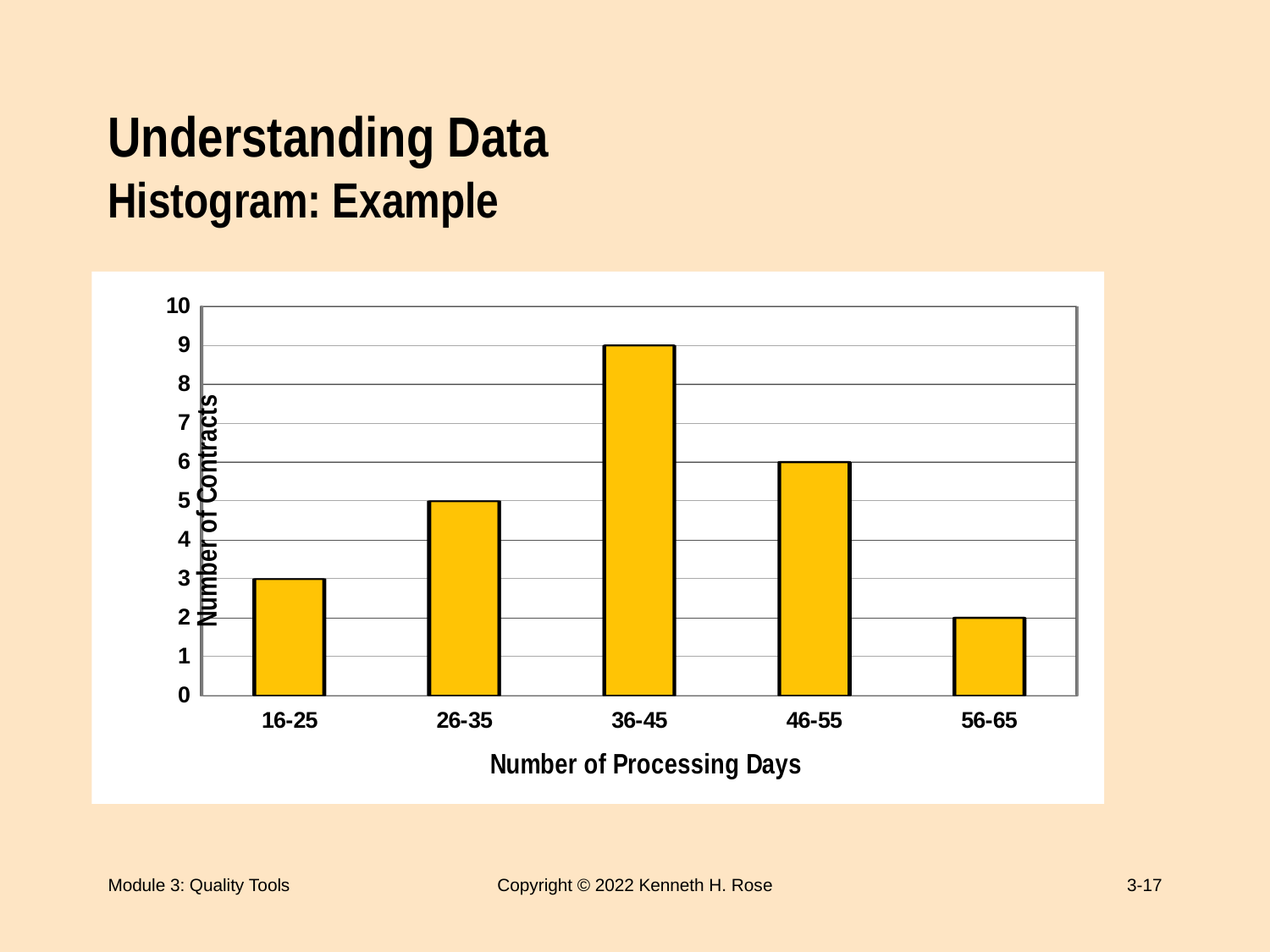
What is the difference in number of contracts between the 36-45 and 46-55 categories? 3 What is the number of contracts for the 16-25 processing days category? 3 What is the number of contracts for the 56-65 processing days category? 2 Which processing days category has the lowest number of contracts? 56-65 What is the label of the y axis? Number of Contracts Which has more contracts, the 26-35 category or the 46-55 category? 46-55 Which processing days category has the highest number of contracts? 36-45 How many contracts are shown for the 36-45 processing days category? 9 What kind of chart is shown on the slide? bar chart What is the label of the x axis? Number of Processing Days How many processing days categories are shown on the x axis? 5 Is the number of contracts for the 26-35 category greater or less than 4? greater